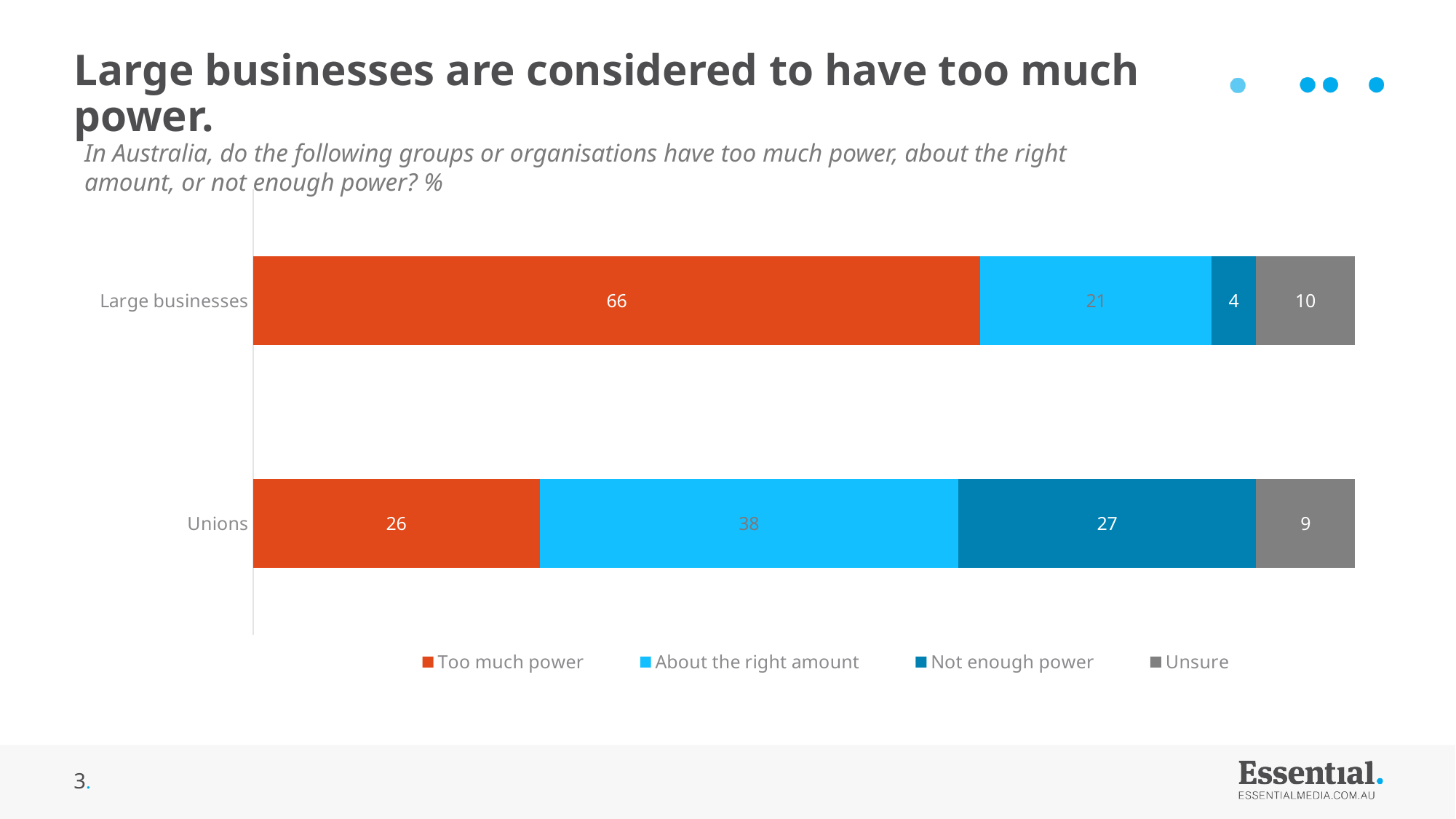
What is the difference between the 'Too much power' values for Large businesses and Unions? 40 Which category has the higher 'Too much power' value, Large businesses or Unions? Large businesses How many series does the legend list? 4 What kind of chart is shown on the slide? Stacked bar chart What is the total of the stacked bar for Unions? 100 What is the value for 'Not enough power' for Unions? 27 How many categories are shown on the chart? 2 What is the 'Unsure' value for Large businesses? 10 Which legend entry is shown in orange-red? Too much power What is the value for 'About the right amount' for Unions? 38 What is the total of the stacked bar for Large businesses? 101 What percentage of respondents say large businesses have too much power? 66